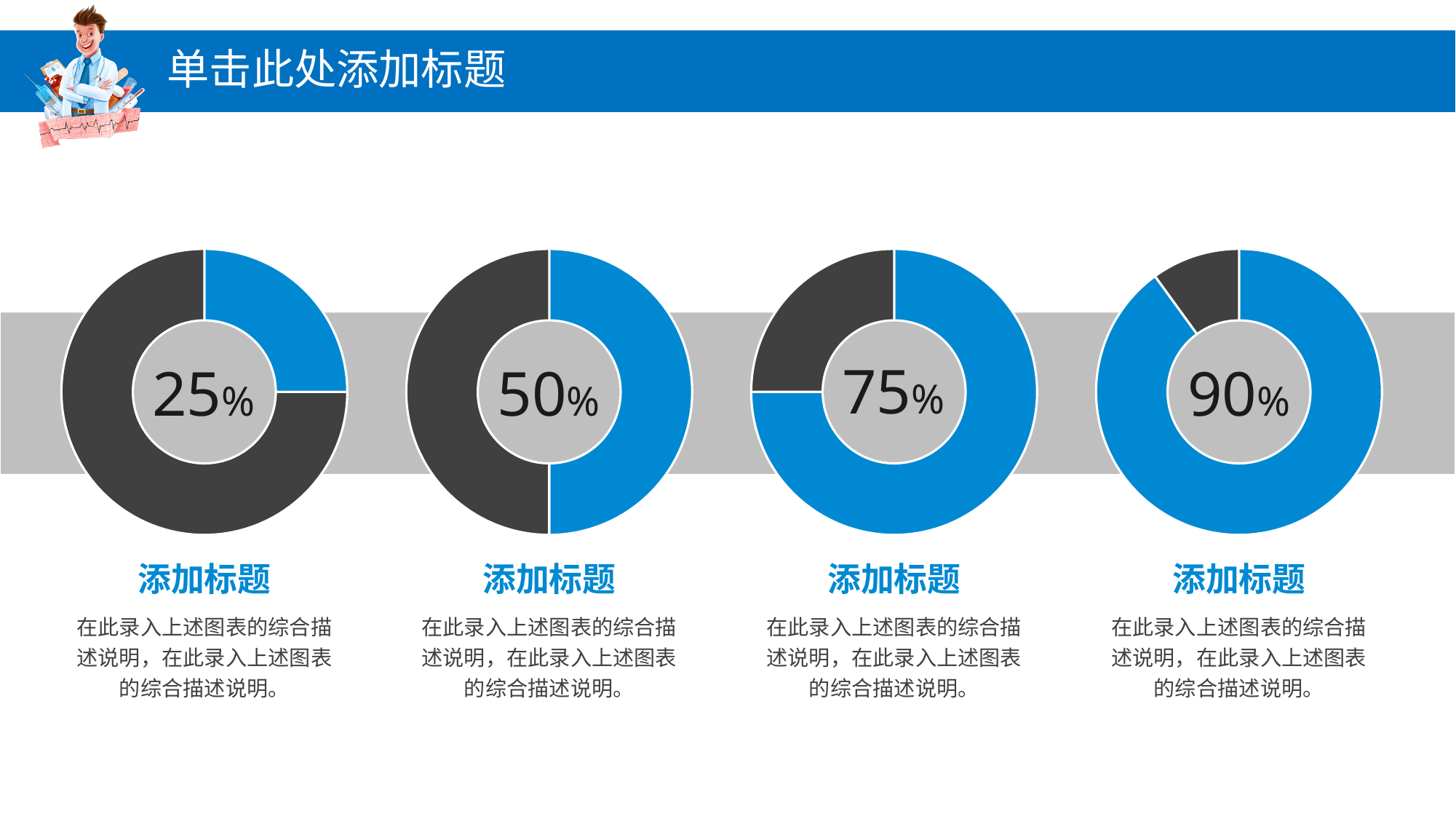
What is the difference between the values of the third and second donut charts from the left? 25% What value is shown in the centre of the leftmost donut chart? 25% How many donut charts are on the slide? 4 Which donut chart shows the highest percentage? the rightmost one (90%) What value is shown in the centre of the rightmost donut chart? 90% What is the difference between the value in the rightmost donut chart and the value in the leftmost donut chart? 65% Which donut chart shows the lowest percentage? the leftmost one (25%) Do the percentages rise or fall when reading the donut charts from left to right? rise Which is larger, the value in the second donut chart or the value in the third donut chart from the left? the third (75%) What value is shown in the centre of the second donut chart from the left? 50% What kind of chart is used on this slide? donut chart What value is shown in the centre of the third donut chart from the left? 75%